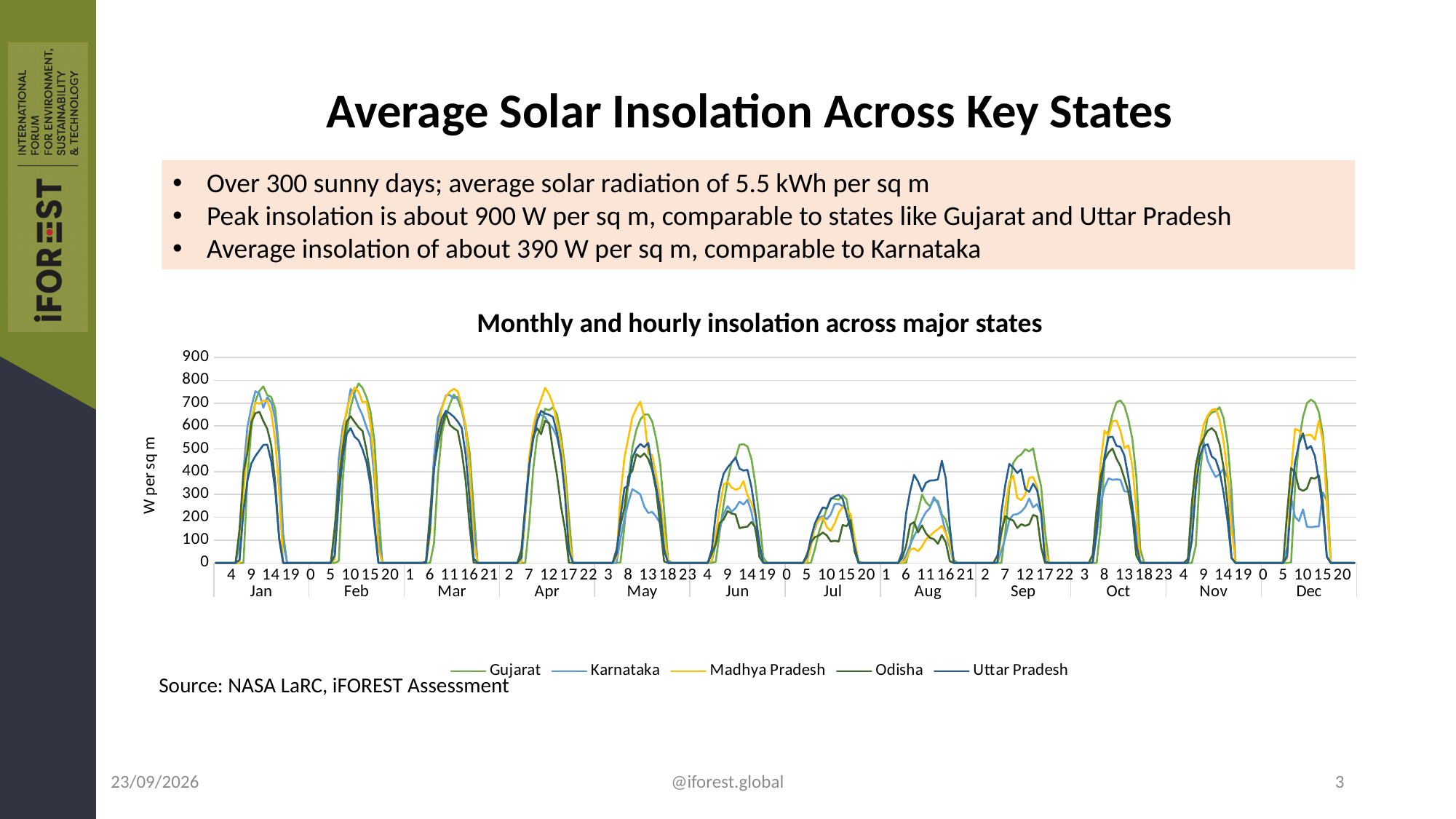
How many months are shown along the x axis of the chart? 12 What kind of chart is shown on the slide? Line chart What is the label on the vertical axis of the chart? W per sq m In Aug, is the peak value for Uttar Pradesh higher or lower than that for Madhya Pradesh? higher How many series does the legend of the chart list? 5 What is the title of the chart? Monthly and hourly insolation across major states Which month shows the lowest peak insolation values across all states? Jul Is the peak value for Gujarat in Feb greater or less than 700? greater Is the peak value for Madhya Pradesh in Jul greater or less than 200? greater Which state has the highest peak value in Oct? Gujarat Is the peak value for Uttar Pradesh in Jan greater or less than 600? less